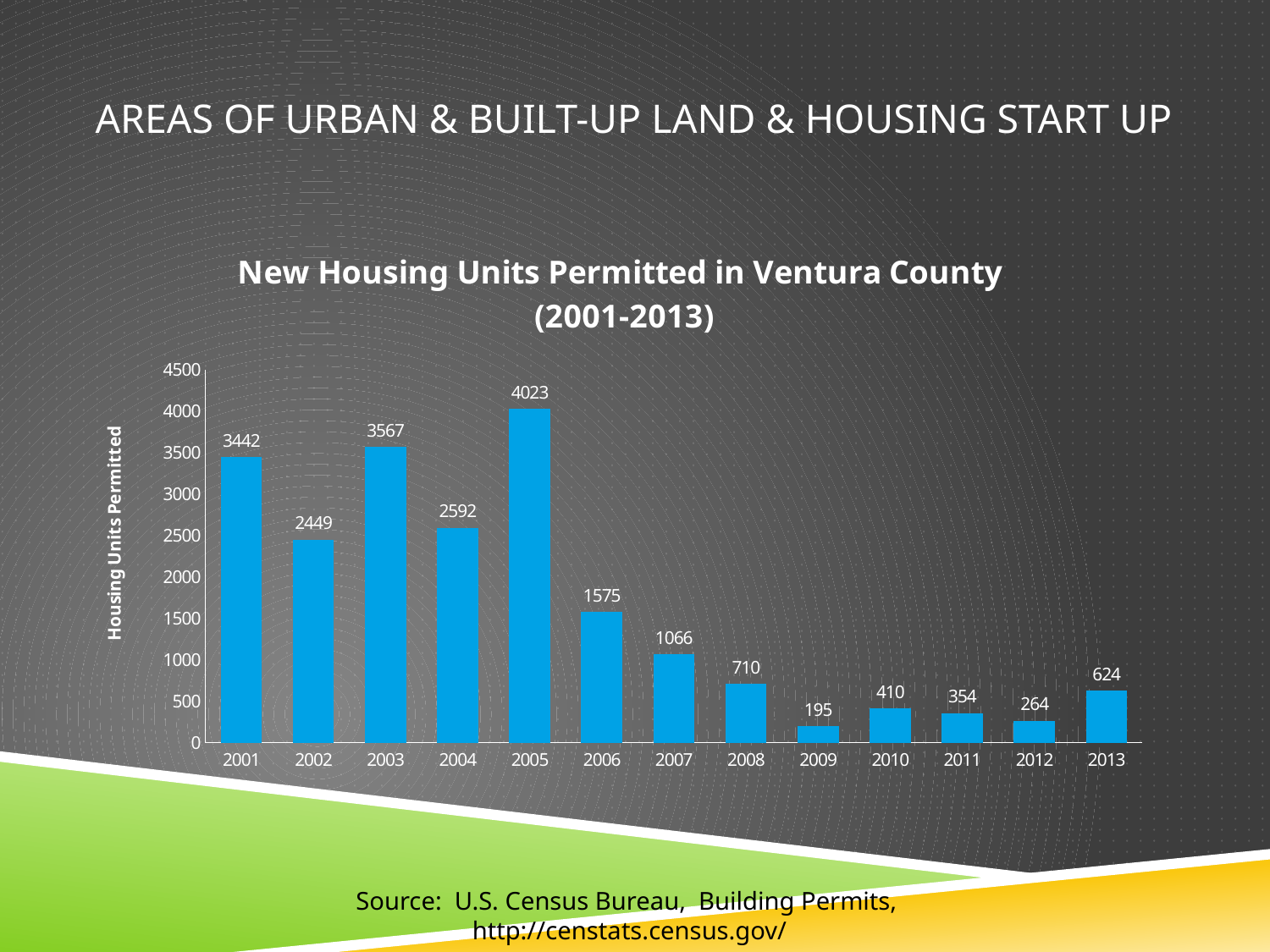
Which year had the lowest number of housing units permitted? 2009 What kind of chart is shown on the slide? Bar chart Which year had more housing units permitted, 2003 or 2004? 2003 What is the difference between the values for 2005 and 2006? 2448 Do the values generally rise or fall from 2005 to 2009? Fall What is the title of the chart? New Housing Units Permitted in Ventura County (2001-2013) What is the label on the vertical axis of the chart? Housing Units Permitted How many years are shown on the x axis of the chart? 13 Which year had the highest number of housing units permitted? 2005 Is the value for 2007 greater or less than 1000? greater What is the value shown for 2009? 195 How many new housing units were permitted in Ventura County in 2005? 4023